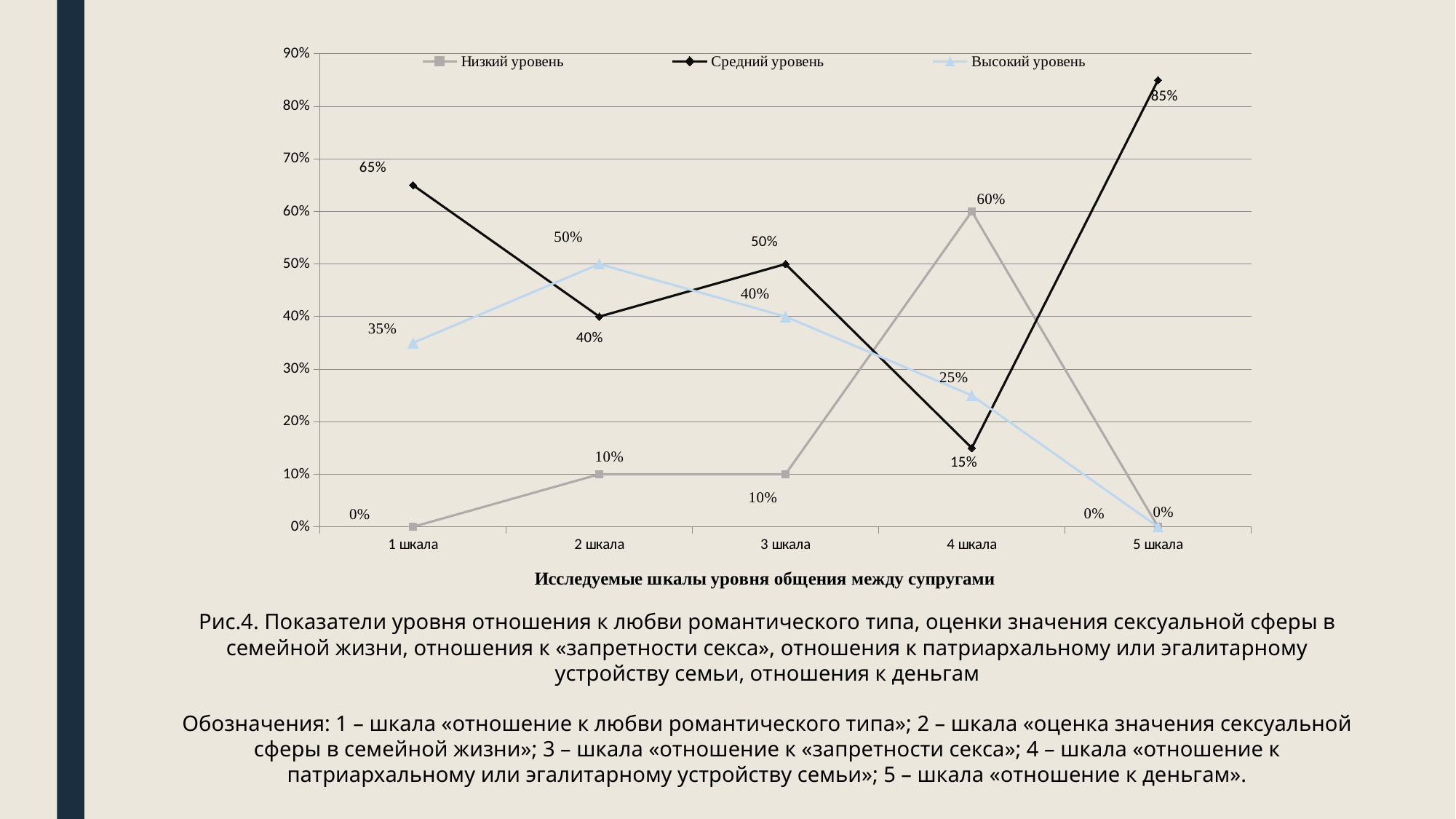
What kind of chart is shown on the slide? Line chart Which is larger for 4 шкала: Низкий уровень or Высокий уровень? Низкий уровень For which category is Средний уровень lowest? 4 шкала What is the value of Средний уровень for 5 шкала? 85% For which category is Высокий уровень highest? 2 шкала What is the x-axis title of the chart? Исследуемые шкалы уровня общения между супругами Does Высокий уровень rise or fall from 3 шкала to 5 шкала? Fall What is the difference between Средний уровень and Высокий уровень for 1 шкала? 30% What is the value of Низкий уровень for 4 шкала? 60% How many series does the legend list? 3 How many categories are shown on the x axis? 5 What is the value of Высокий уровень for 1 шкала? 35%